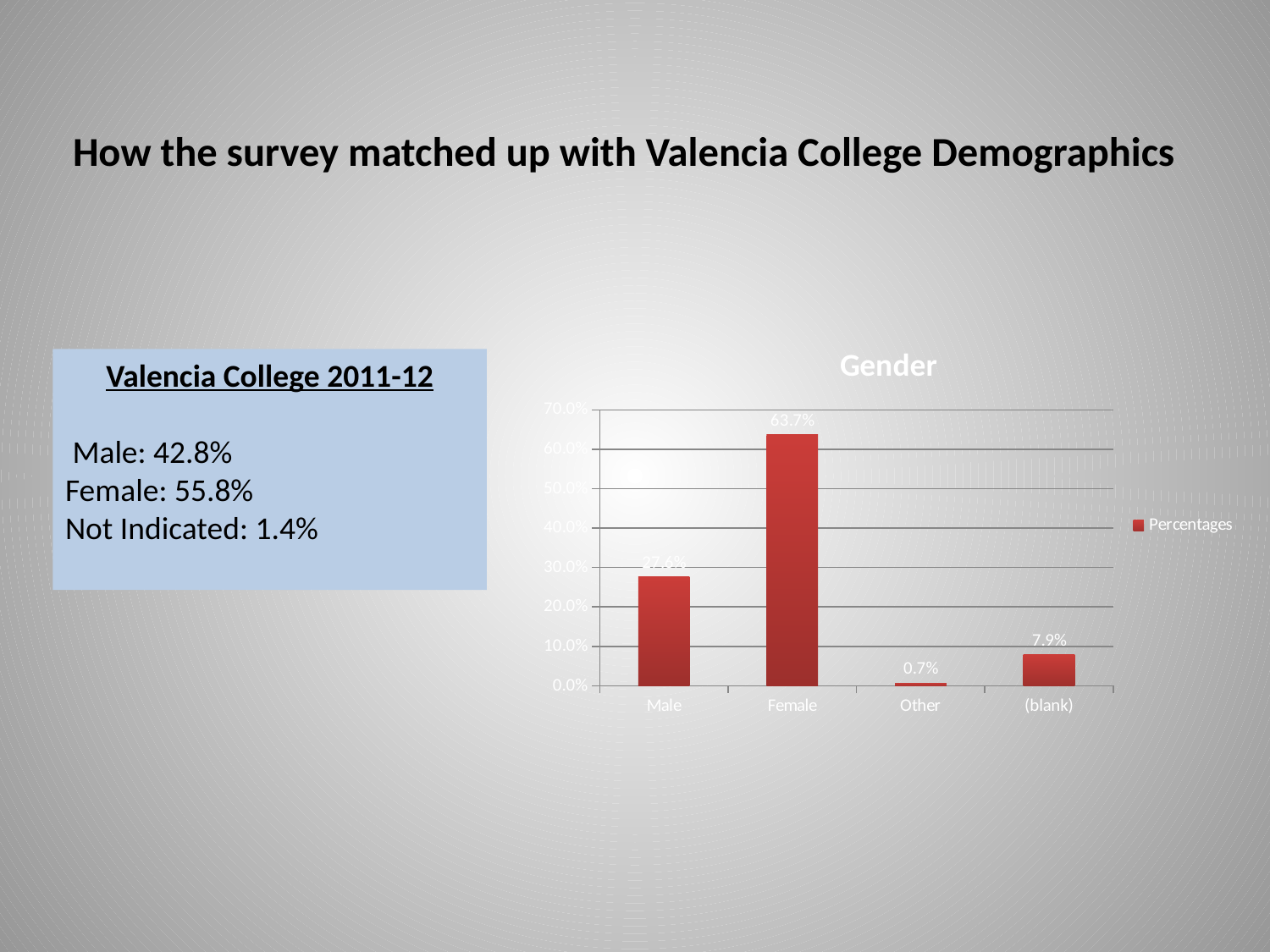
What is the value for (blank) in the Gender chart? 7.9% What type of chart is shown on the slide? bar chart Is the value for Male in the Gender chart greater or less than 20.0%? greater Which is larger in the Gender chart, the value for Male or the value for (blank)? Male How many series does the legend of the Gender chart list? 1 How many categories are shown on the x axis of the Gender chart? 4 Which category has the highest value in the Gender chart? Female Which category has the lowest value in the Gender chart? Other What is the value for Other in the Gender chart? 0.7% What is the title of the chart? Gender What is the value for Female in the Gender chart? 63.7% What is the difference between the Female and (blank) values in the Gender chart? 55.8%